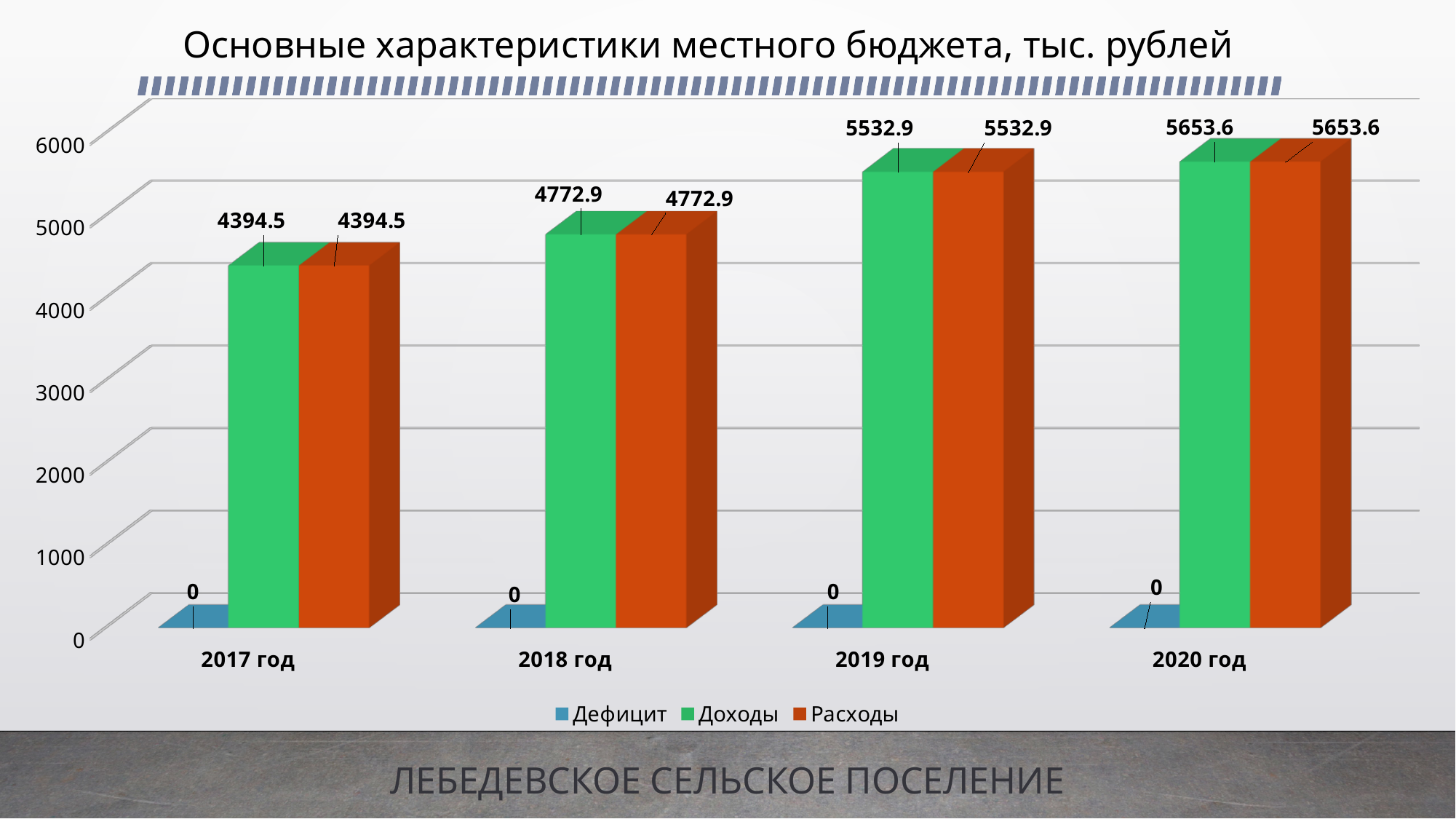
What is the value of Дефицит for 2018 год? 0 What is the value of Расходы for 2019 год? 5532.9 Which year has the highest Доходы value? 2020 год How many years are shown on the x axis? 4 Do the Доходы values rise or fall from 2017 год to 2020 год? rise Which year has the lowest Расходы value? 2017 год What is the value of Доходы for 2017 год? 4394.5 How many series does the legend list? 3 Which is larger: Расходы in 2019 год or Расходы in 2018 год? Расходы in 2019 год What is the difference between Доходы in 2018 год and Доходы in 2017 год? 378.4 What is the value of Доходы for 2020 год? 5653.6 Is the value of Доходы for 2019 год greater or less than 5000? greater